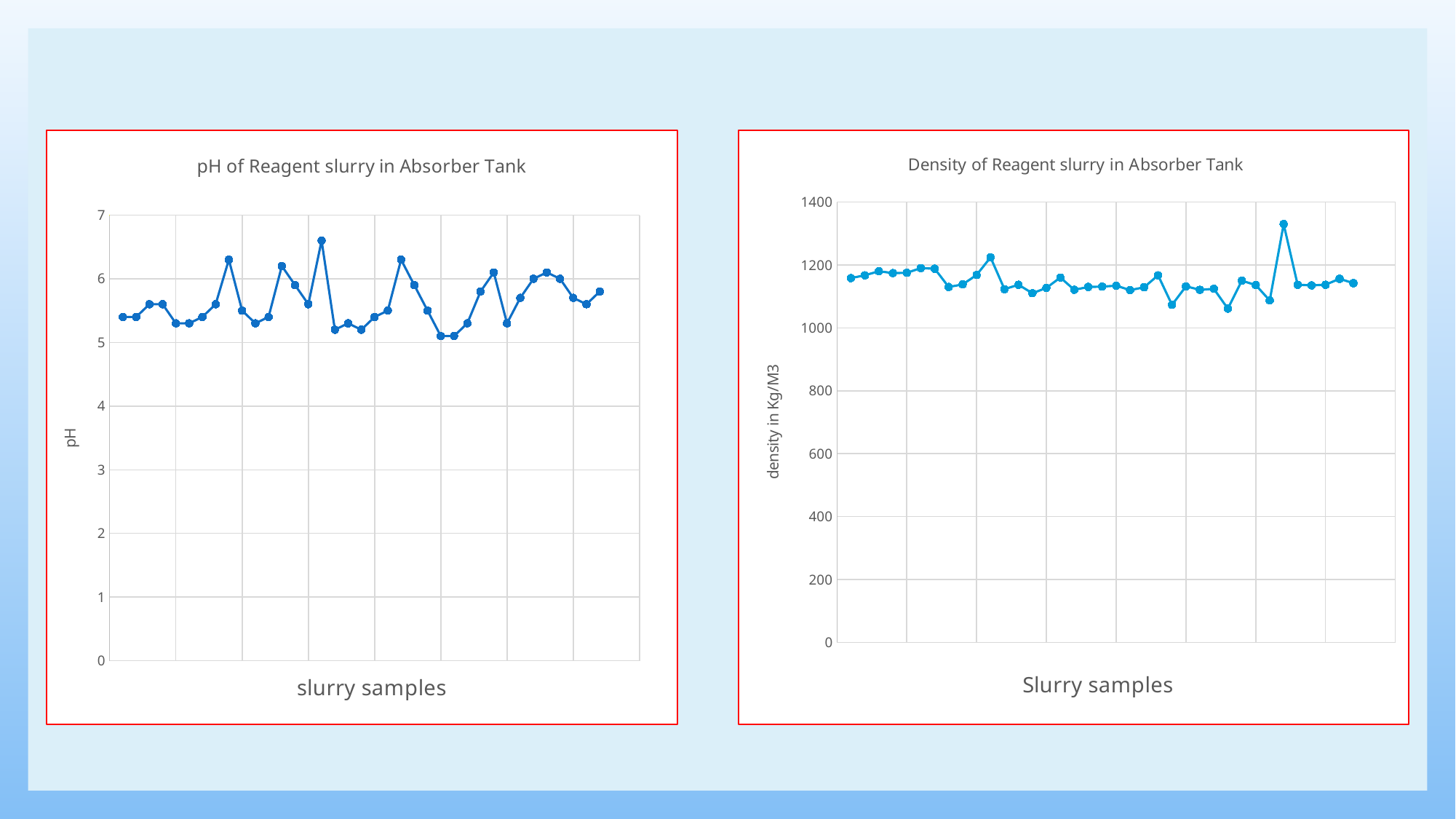
In the 'pH of Reagent slurry in Absorber Tank' chart, is the highest plotted pH value greater or less than 7? less What kind of chart is the 'Density of Reagent slurry in Absorber Tank' chart? line chart In the 'Density of Reagent slurry in Absorber Tank' chart, what is the label of the y axis? density in Kg/M3 In the 'pH of Reagent slurry in Absorber Tank' chart, is the lowest plotted pH value greater or less than 6? less In the 'pH of Reagent slurry in Absorber Tank' chart, is the highest plotted pH value greater or less than 6? greater What kind of chart is the 'pH of Reagent slurry in Absorber Tank' chart? line chart In the 'pH of Reagent slurry in Absorber Tank' chart, what is the label of the y axis? pH What is the maximum value shown on the y axis of the 'Density of Reagent slurry in Absorber Tank' chart? 1400